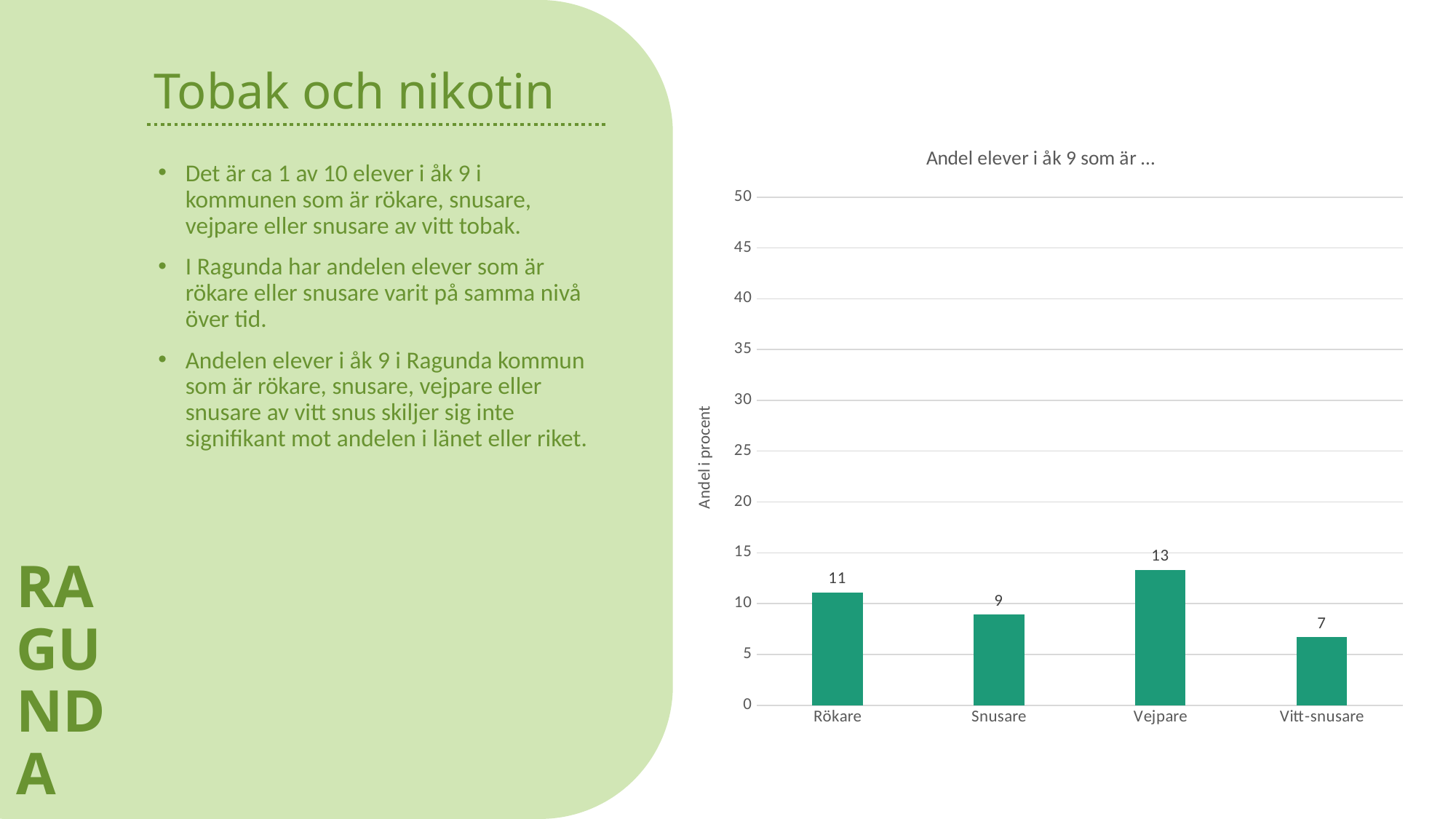
Is the value for Vejpare greater or less than 15? less Which category has the highest value? Vejpare What is the title of the chart? Andel elever i åk 9 som är … What is the value for Rökare? 11 What is the value for Vitt-snusare? 7 Which is larger, the value for Rökare or the value for Snusare? Rökare What is the value for Vejpare? 13 What is the value for Snusare? 9 How many categories are shown on the x axis? 4 Which category has the lowest value? Vitt-snusare What kind of chart is shown on the slide? bar chart What is the difference between the values for Vejpare and Vitt-snusare? 6